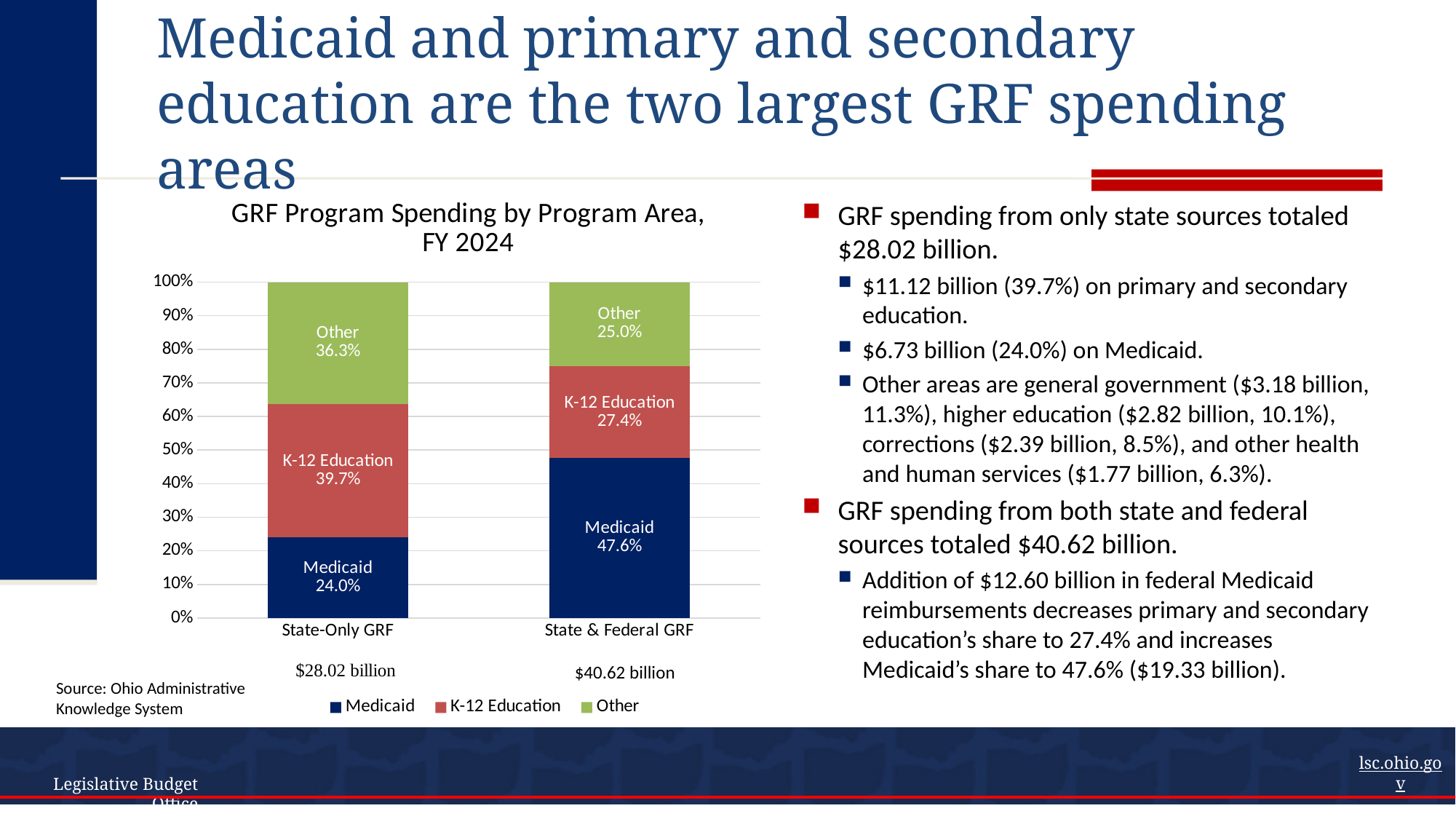
How many bars are shown in the chart? 2 What is the Medicaid share of State & Federal GRF spending? 47.6% What kind of chart is shown on the slide? Stacked bar chart Which program area has the smallest share in the State & Federal GRF bar? Other How many series does the legend list? 3 What is the Medicaid share of State-Only GRF spending? 24.0% What is the Other share of State-Only GRF spending? 36.3% Which program area has the largest share in the State-Only GRF bar? K-12 Education What is the title of the chart? GRF Program Spending by Program Area, FY 2024 What is the K-12 Education share of State & Federal GRF spending? 27.4% How much larger is Medicaid's share in State & Federal GRF than in State-Only GRF? 23.6 percentage points Which is larger: the K-12 Education share in State-Only GRF or in State & Federal GRF? State-Only GRF